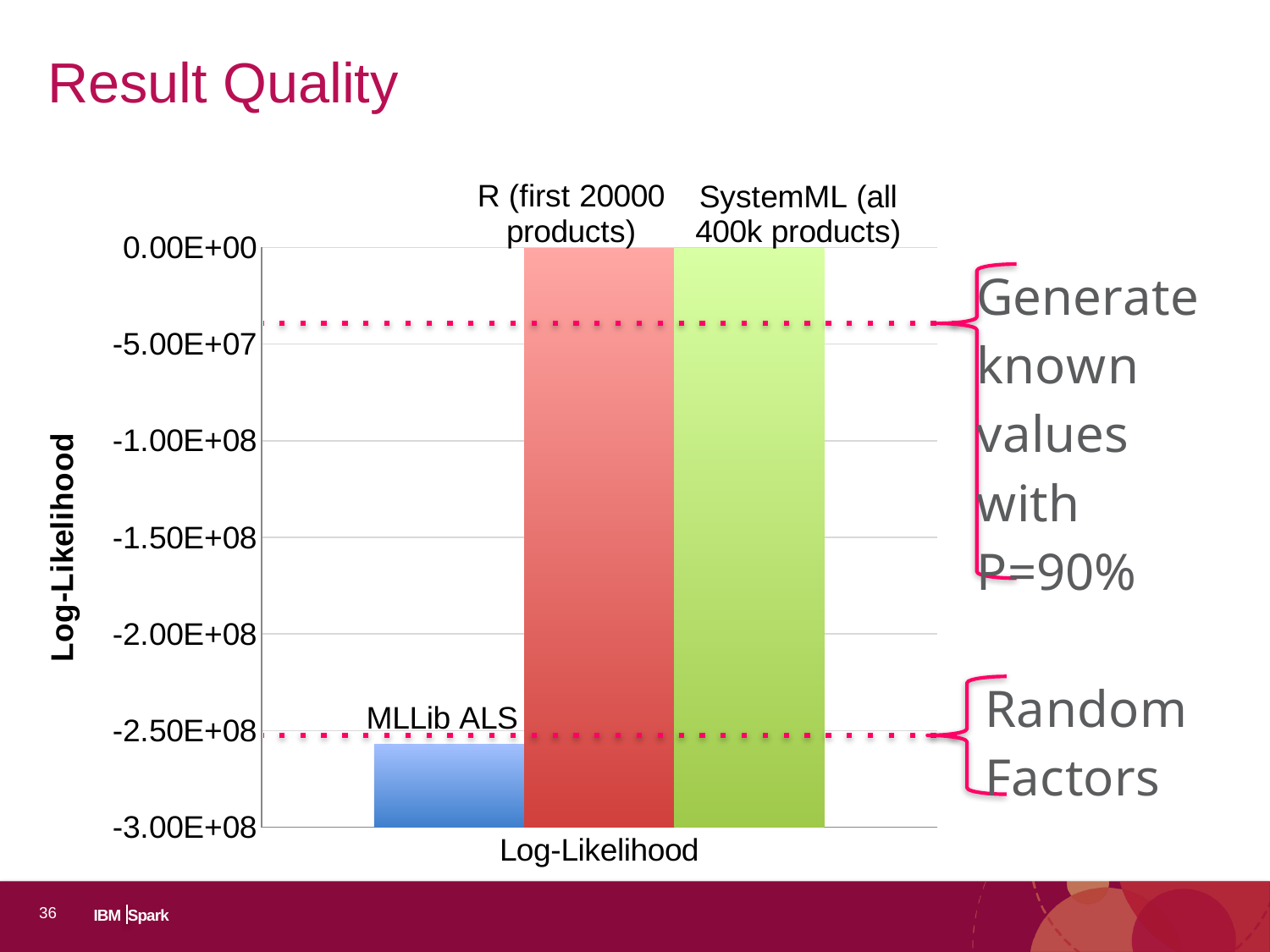
What is the title of the vertical axis of the chart? Log-Likelihood Is the log-likelihood value for SystemML (all 400k products) greater or less than -5.00E+07? greater Which bar has the lowest log-likelihood value? MLLib ALS What kind of chart is shown on the slide? bar chart Is the log-likelihood value for MLLib ALS greater or less than -2.50E+08? less What colour is the MLLib ALS bar? blue How many bars are plotted in the chart? 3 Is the log-likelihood value for MLLib ALS greater or less than -3.00E+08? greater Which has the larger log-likelihood value, SystemML (all 400k products) or MLLib ALS? SystemML (all 400k products) Which has the larger log-likelihood value, MLLib ALS or R (first 20000 products)? R (first 20000 products)